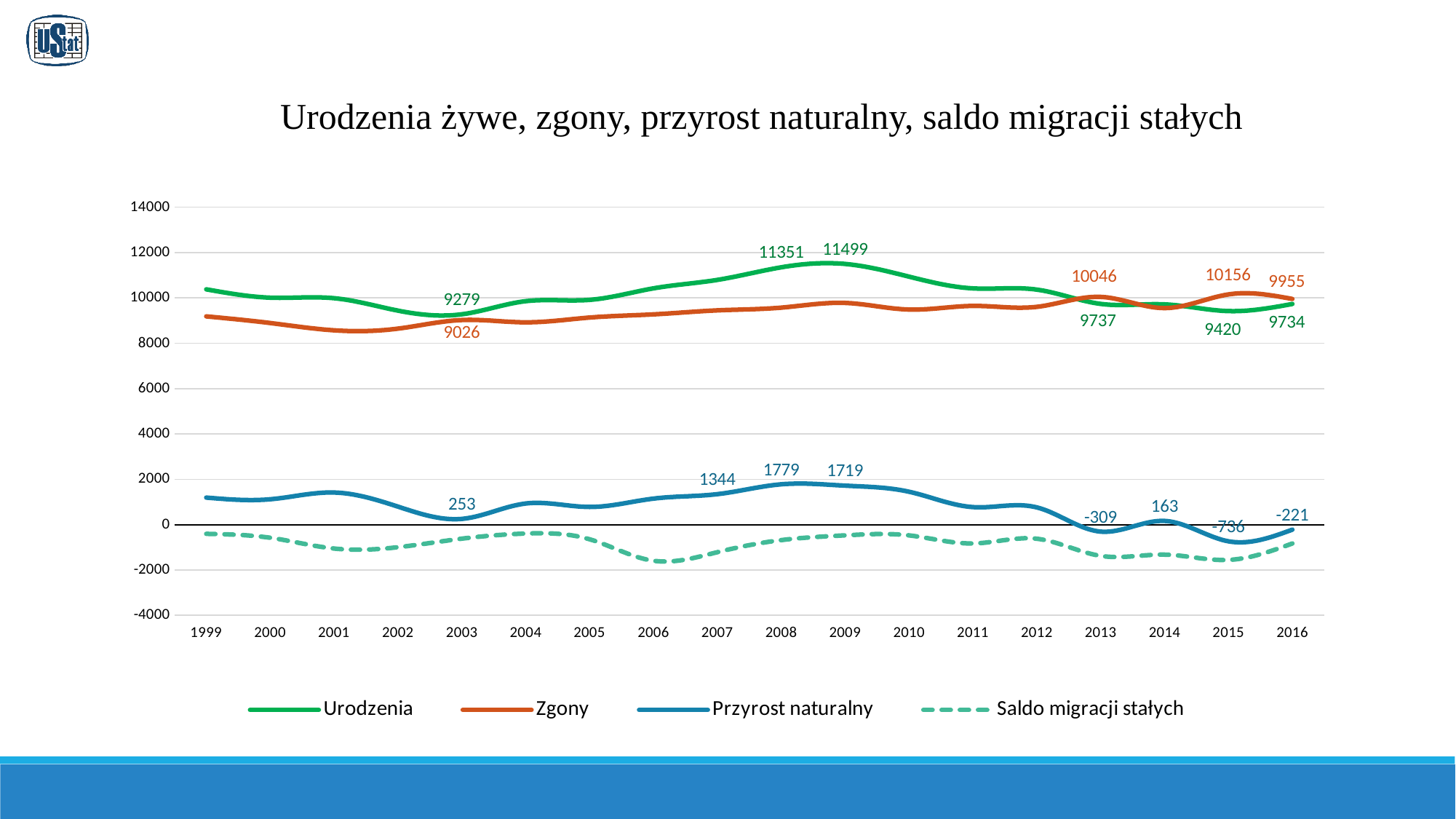
How many series does the legend list? 4 How many years are shown on the x axis? 18 What kind of chart is shown on the slide? Line chart What is the value of Przyrost naturalny in 2015? -736 What is the value of Przyrost naturalny in 2008? 1779 What is the difference between Zgony and Urodzenia in 2016? 221 Is the value of Saldo migracji stałych in 2006 greater or less than 0? less By how much did Urodzenia increase from 2008 to 2009? 148 What is the value of Zgony in 2015? 10156 In 2013, which is larger: Urodzenia or Zgony? Zgony In which year does the Urodzenia line reach its highest value? 2009 What is the value of Urodzenia in 2009? 11499